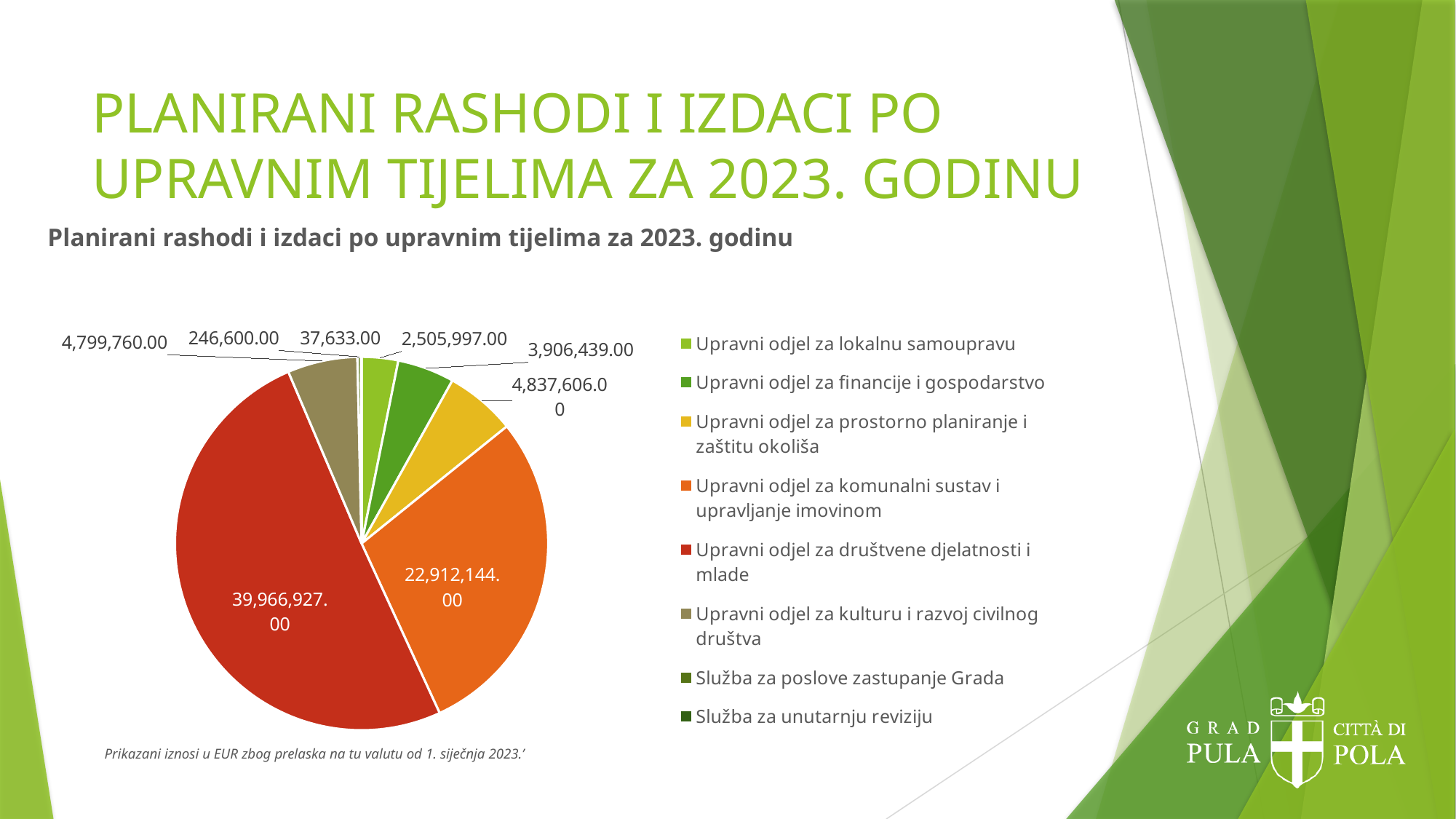
What is the value for Služba za unutarnju reviziju? 37,633.00 Which is larger, the value for Upravni odjel za financije i gospodarstvo or for Upravni odjel za prostorno planiranje i zaštitu okoliša? Upravni odjel za prostorno planiranje i zaštitu okoliša Which upravno tijelo has the largest planned expenditure? Upravni odjel za društvene djelatnosti i mlade What is the value for Upravni odjel za prostorno planiranje i zaštitu okoliša? 4,837,606.00 What is the value for Upravni odjel za društvene djelatnosti i mlade? 39,966,927.00 Which upravno tijelo has the smallest planned expenditure? Služba za unutarnju reviziju What is the value for Upravni odjel za komunalni sustav i upravljanje imovinom? 22,912,144.00 What is the difference between the values for Upravni odjel za društvene djelatnosti i mlade and Upravni odjel za komunalni sustav i upravljanje imovinom? 17,054,783.00 What is the value for Upravni odjel za lokalnu samoupravu? 2,505,997.00 What type of chart is shown on the slide? pie chart How many entries does the legend of the pie chart list? 8 What is the title of the chart? Planirani rashodi i izdaci po upravnim tijelima za 2023. godinu